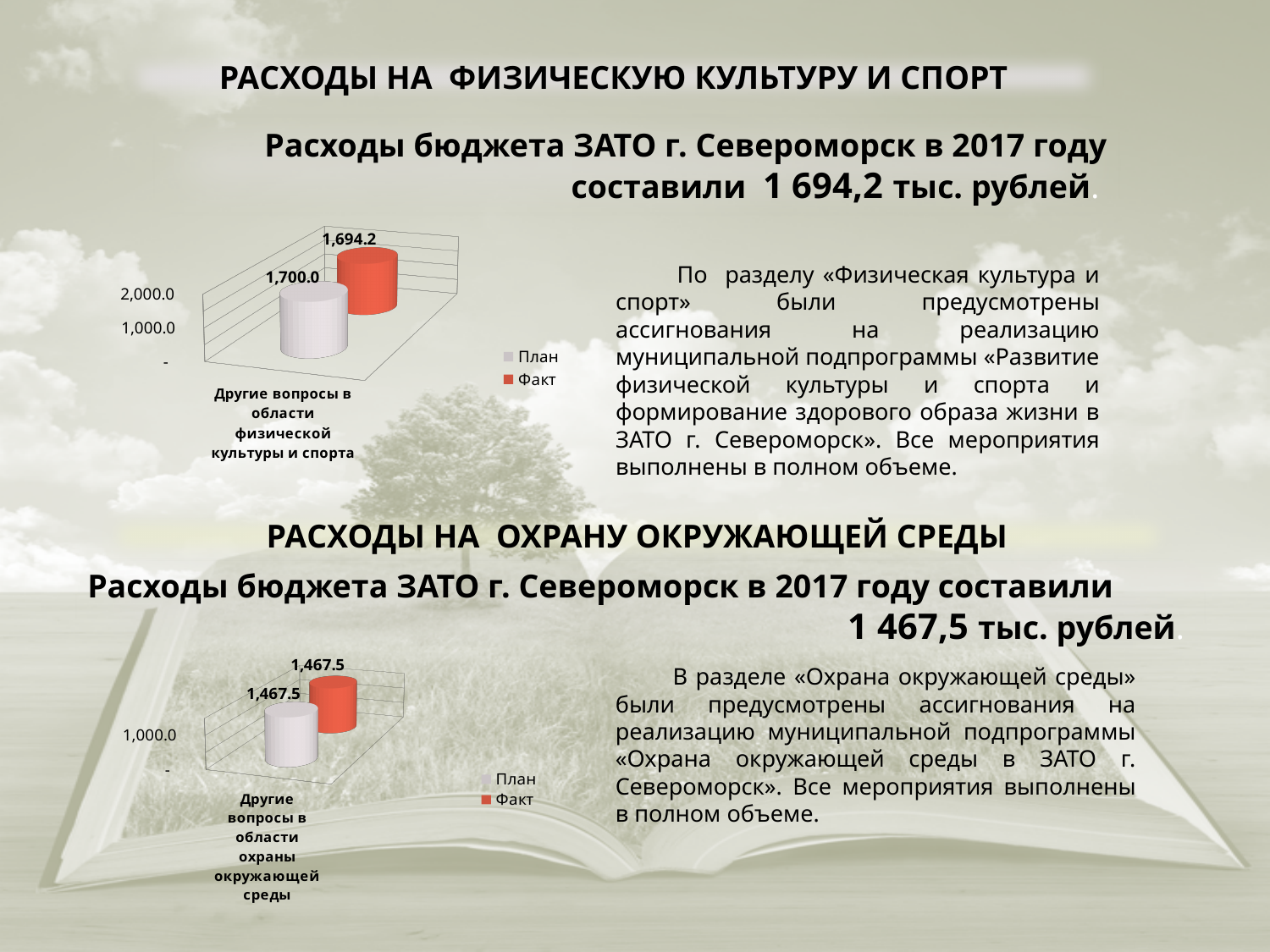
In the top chart, is the value for Факт greater or less than 1,000.0? greater In the bottom chart, what is the name of the category shown on the x axis? Другие вопросы в области охраны окружающей среды In the top chart, what is the value for Факт? 1,694.2 In the bottom chart, what is the value for План? 1,467.5 In the bottom chart, what is the value for Факт? 1,467.5 In the top chart, which is larger, План or Факт? План What kind of chart is the top chart? bar chart In the top chart, what is the value for План? 1,700.0 In the bottom chart, what is the difference between План and Факт? 0.0 In the top chart, what is the difference between План and Факт? 5.8 In the top chart, how many series does the legend list? 2 In the bottom chart, how many categories are shown on the x axis? 1